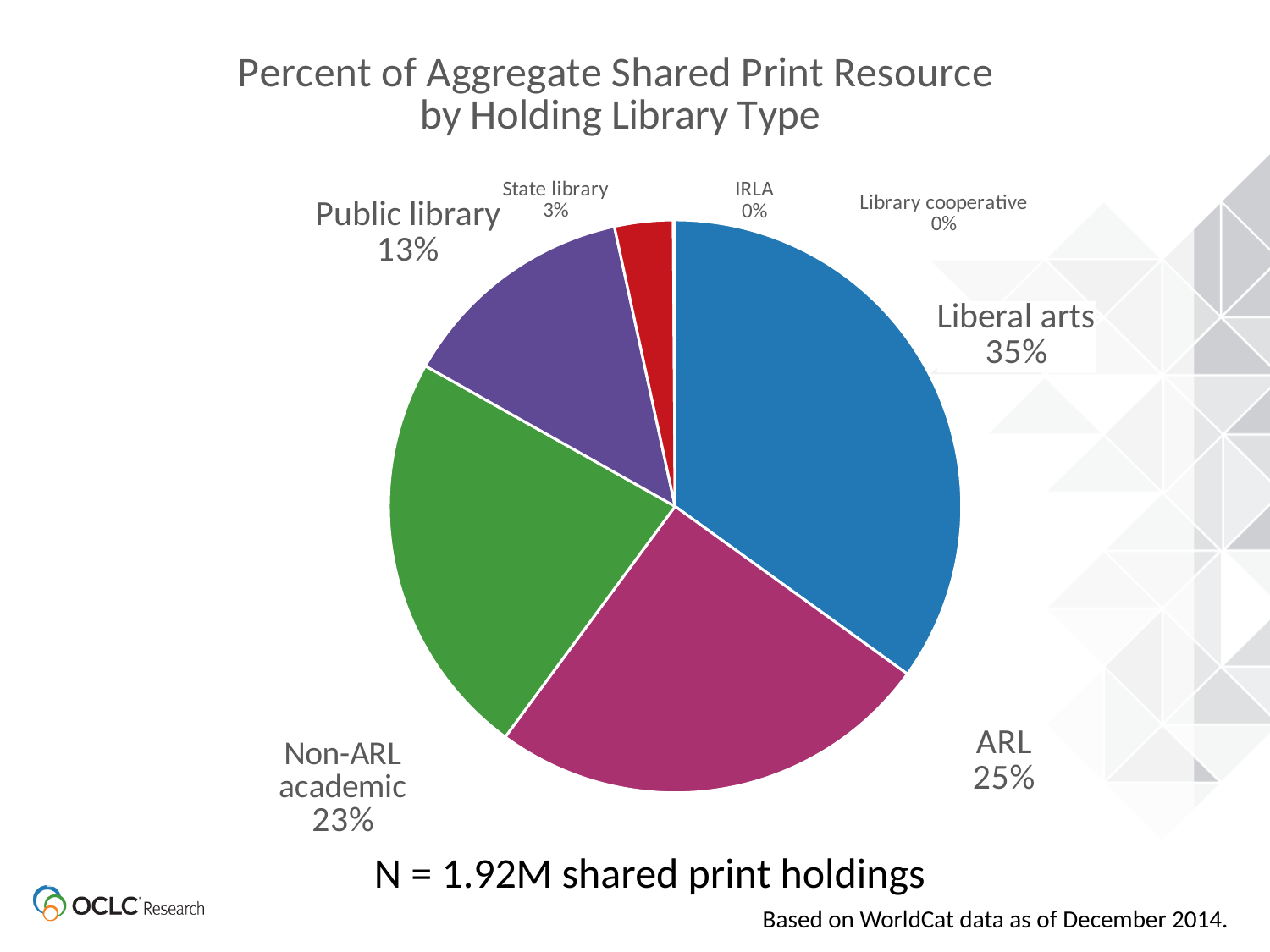
How many percentage points larger is the Liberal arts share than the ARL share? 10 What share of the aggregate shared print resource is held by Public libraries? 13% What is the title of the chart? Percent of Aggregate Shared Print Resource by Holding Library Type How many holding library types are labelled on the pie chart? 7 What share of the aggregate shared print resource is held by ARL libraries? 25% What share of the aggregate shared print resource is held by Liberal arts libraries? 35% What is the total number of shared print holdings (N) stated below the chart? 1.92M Which share is larger, Non-ARL academic or Public library? Non-ARL academic Which holding library type has the largest share of the pie? Liberal arts What kind of chart is shown on the slide? pie chart